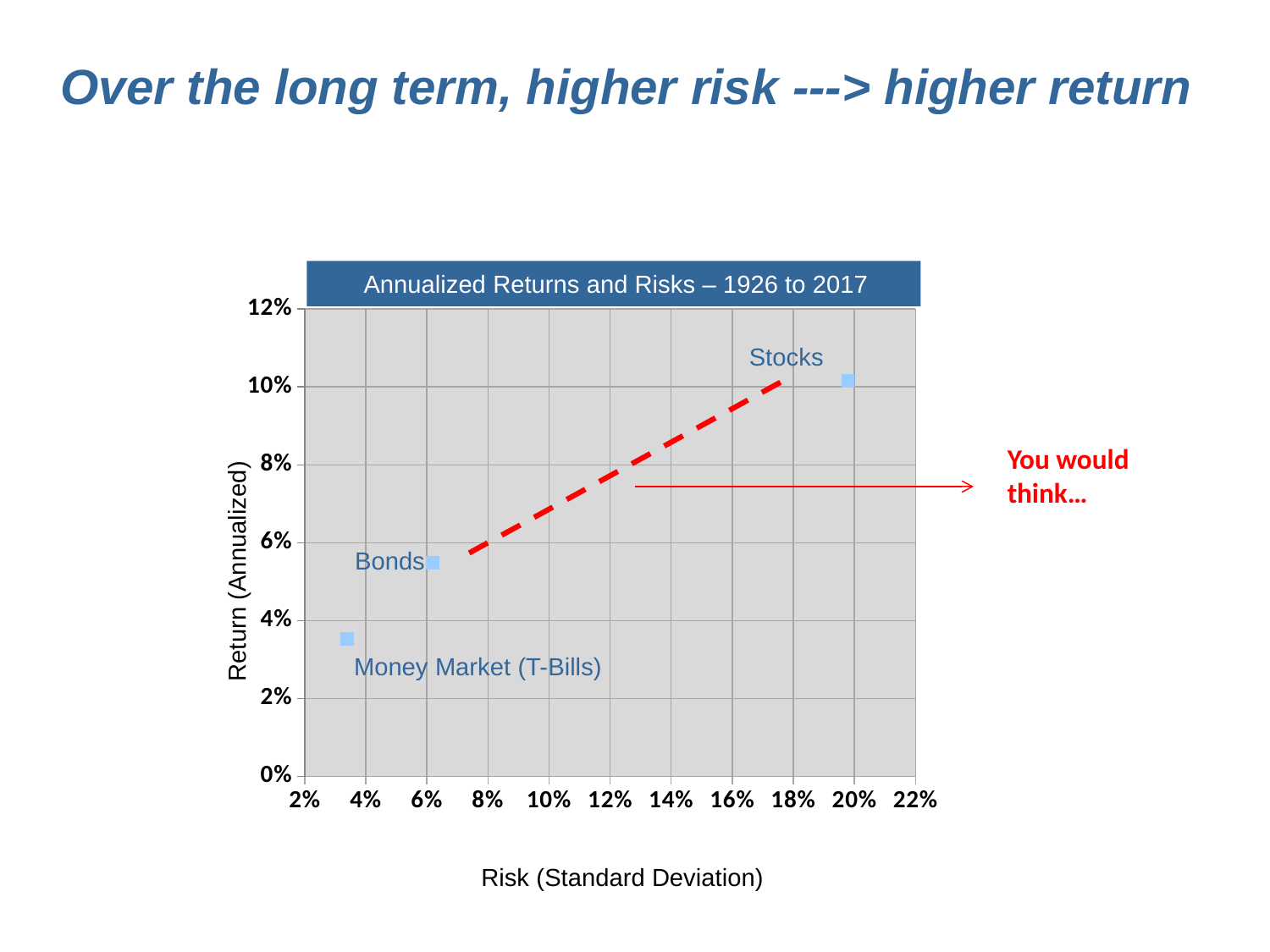
What is the title of the chart? Annualized Returns and Risks – 1926 to 2017 Which asset class has the highest risk (standard deviation)? Stocks Is the risk (standard deviation) for Stocks greater or less than 18%? greater What kind of chart is shown on the slide? Scatter chart Which asset class has the highest annualized return? Stocks Which asset class has the lowest annualized return? Money Market (T-Bills) How many data points are plotted on the chart? 3 As risk increases along the x axis, do the annualized returns rise or fall? Rise Which has a higher annualized return, Bonds or Money Market (T-Bills)? Bonds Which asset class has the lowest risk (standard deviation)? Money Market (T-Bills) Is the annualized return for Bonds greater or less than 6%? less